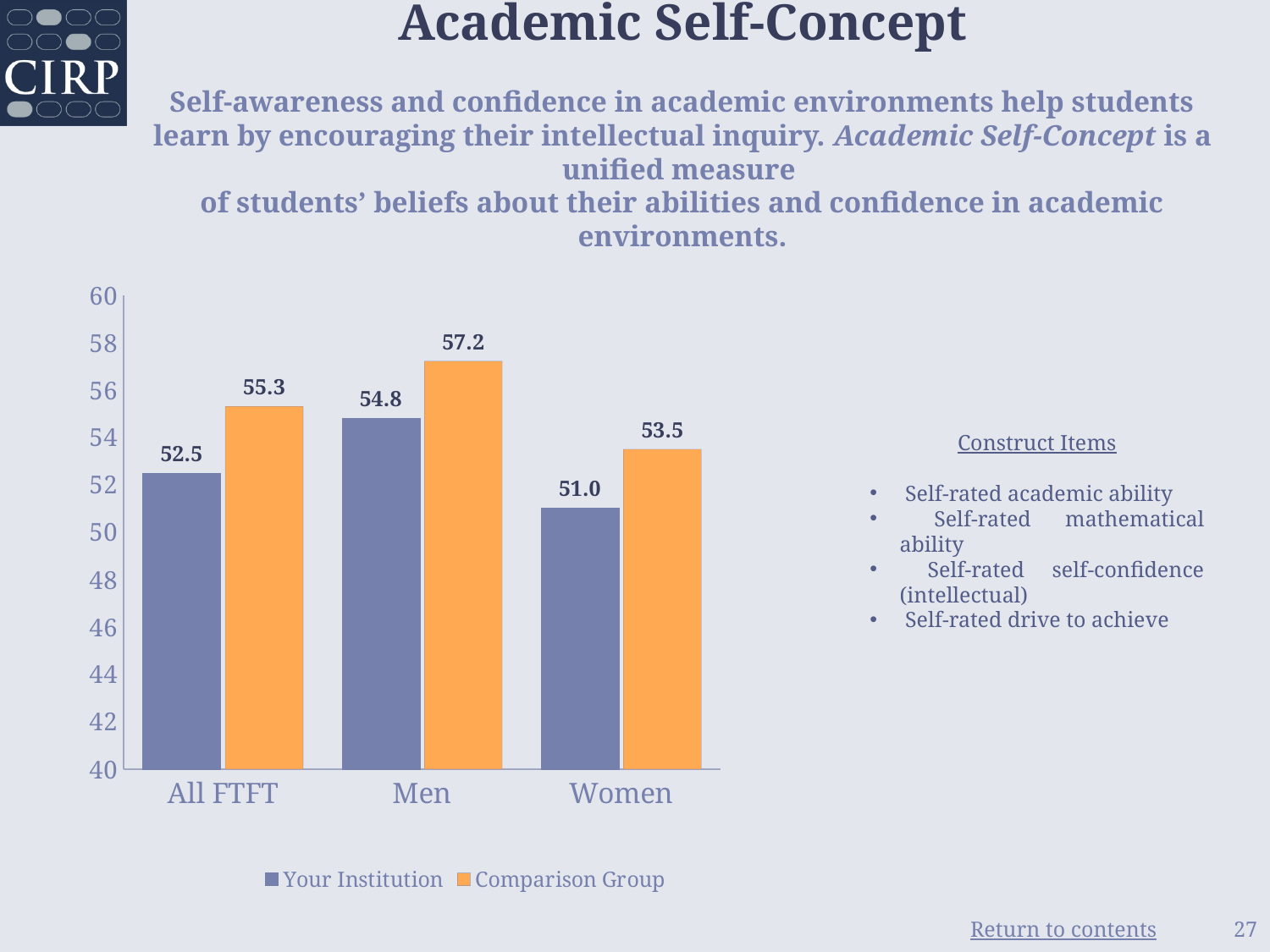
Which category has the lowest Your Institution value? Women Which is larger for All FTFT: Your Institution or the Comparison Group? Comparison Group Is the value for Your Institution in the Women category greater or less than 52? less What is the difference between the Comparison Group and Your Institution values for Men? 2.4 What is the value for Your Institution in the Men category? 54.8 What is the difference between the Comparison Group and Your Institution values for Women? 2.5 What is the value for Your Institution in the All FTFT category? 52.5 What is the value for the Comparison Group in the Women category? 53.5 What kind of chart is shown on the slide? bar chart How many series does the legend list? 2 Which category has the highest Comparison Group value? Men How many categories are shown on the x axis? 3